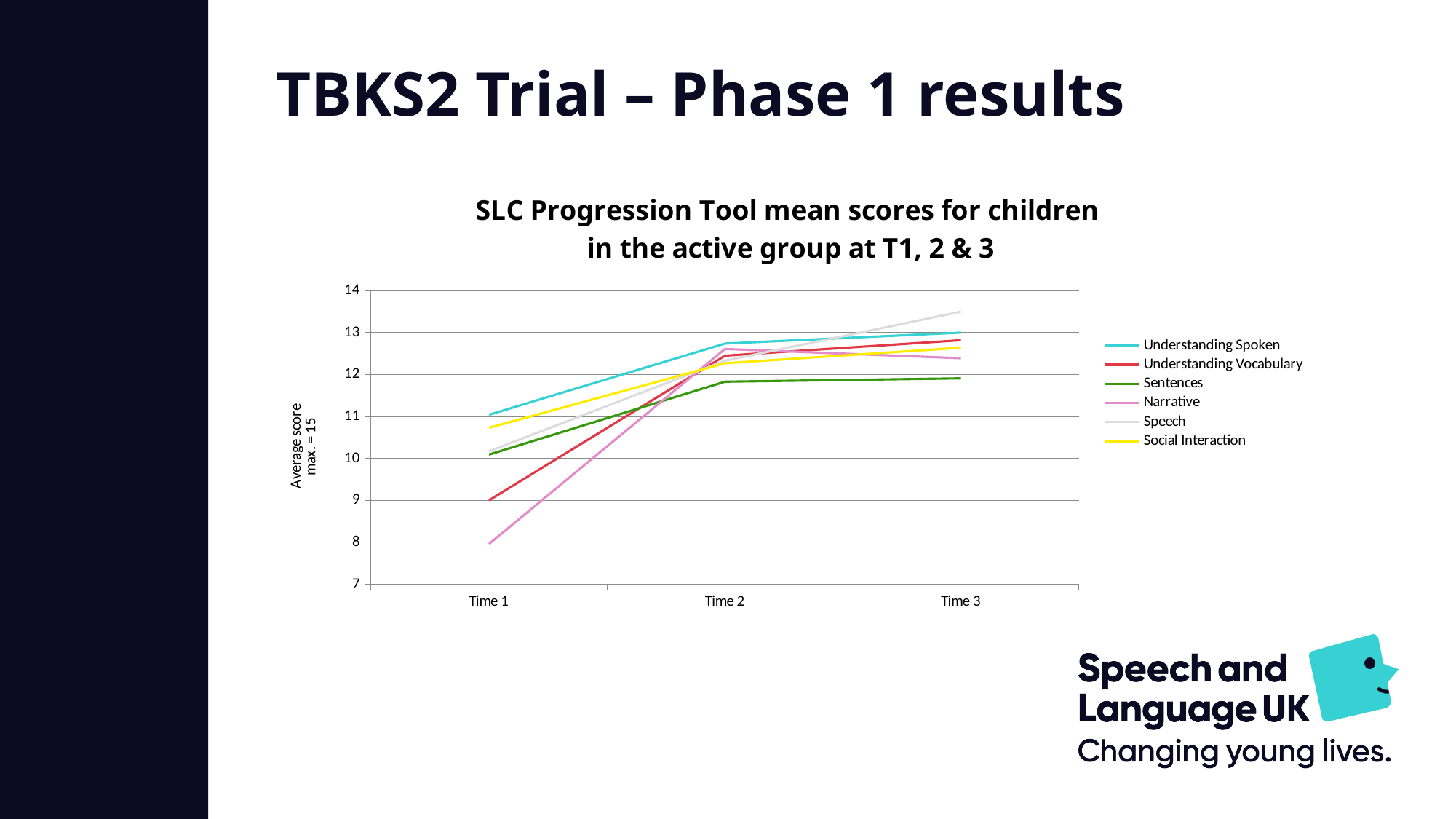
Which series has the lowest score at Time 3? Sentences Is the value for Sentences at Time 2 greater or less than 12? less At Time 2, which is larger: Understanding Spoken or Sentences? Understanding Spoken Is the value for Understanding Vocabulary at Time 1 greater or less than 10? less Does the Narrative series rise or fall from Time 1 to Time 2? rise Which series has the highest score at Time 3? Speech Is the value for Speech at Time 3 greater or less than 13? greater How many series does the legend list? 6 How many time points are plotted along the x axis? 3 Which series has the lowest score at Time 1? Narrative Which series has the highest score at Time 1? Understanding Spoken What kind of chart is shown on the slide? line chart